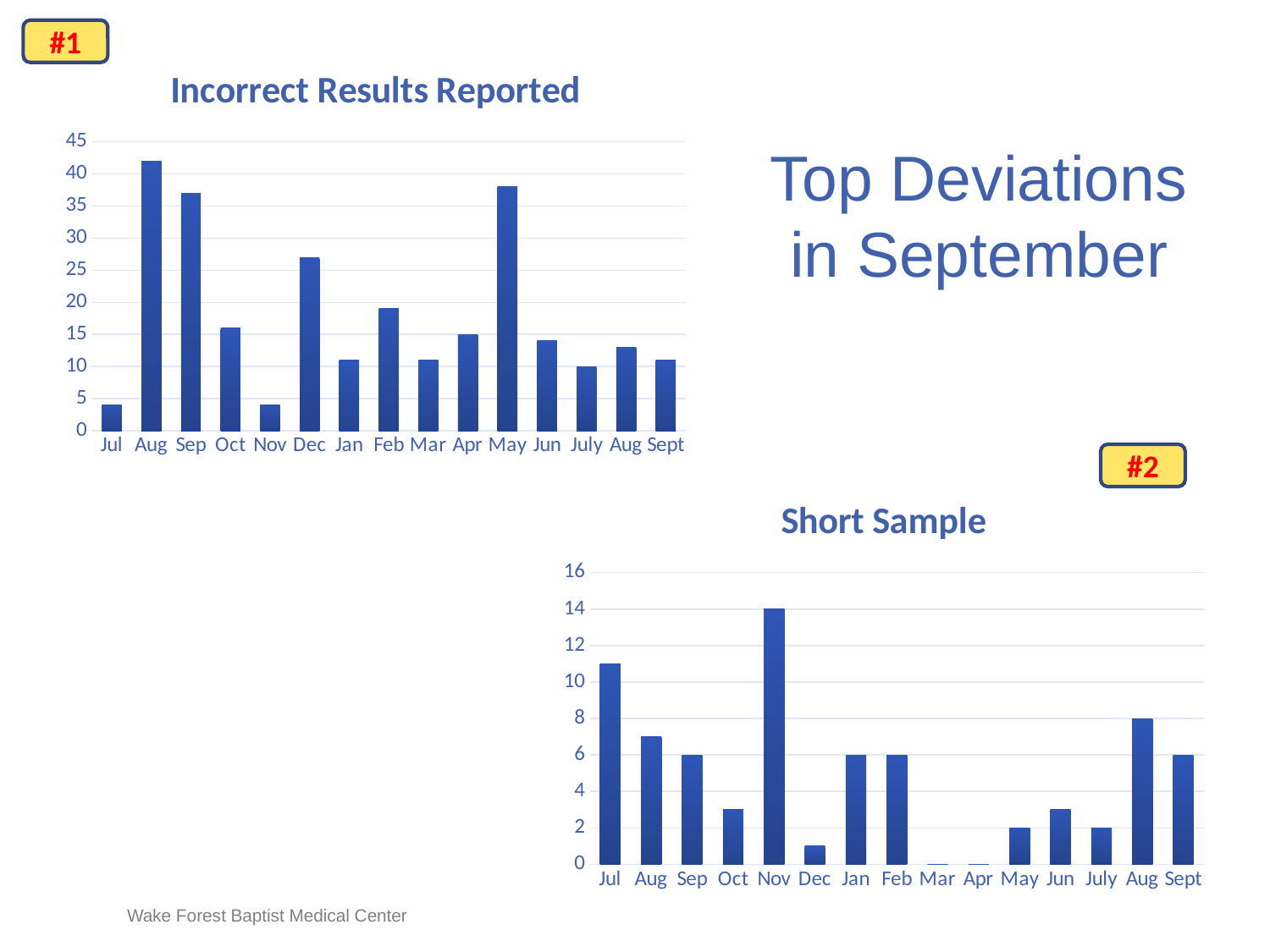
In the 'Incorrect Results Reported' chart, which month has the highest value? Aug What type of chart is the 'Incorrect Results Reported' chart? bar chart In the 'Short Sample' chart, what is the value for Nov? 14 In the 'Short Sample' chart, is the value for Jul greater or less than 10? greater In the 'Short Sample' chart, what is the value for the second Aug bar (near the right end)? 8 In the 'Short Sample' chart, which is larger, the value for Oct or the value for Dec? Oct In the 'Incorrect Results Reported' chart, which is larger, the value for Sep or the value for Oct? Sep In the 'Short Sample' chart, which month has the highest value? Nov In the 'Incorrect Results Reported' chart, how many months are shown on the x axis? 15 In the 'Incorrect Results Reported' chart, is the value for Jan greater or less than 15? less What is the title of the chart in the lower right of the slide? Short Sample In the 'Incorrect Results Reported' chart, is the value for Dec greater or less than 25? greater